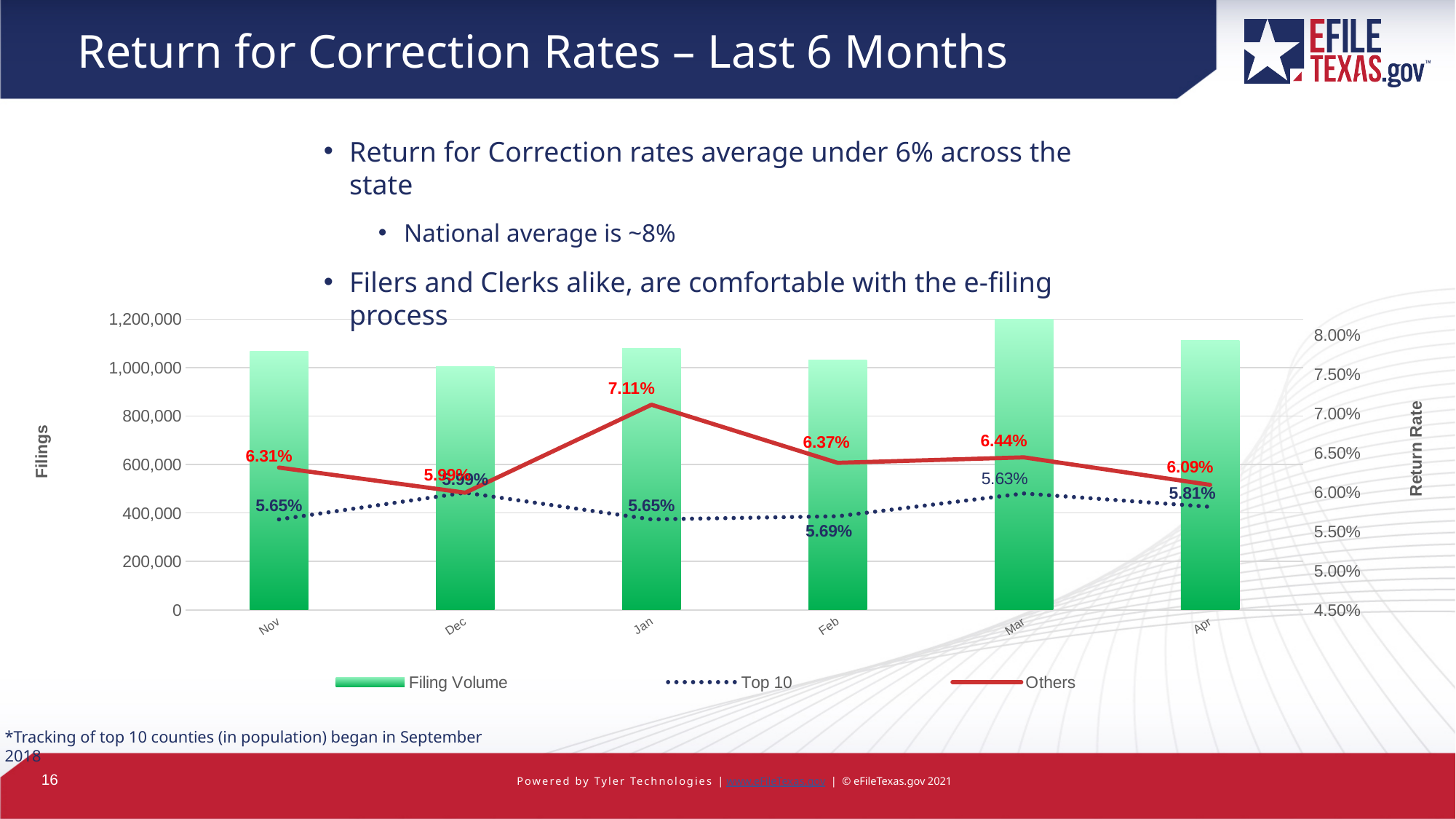
What is the Top 10 return rate for Apr? 5.81% Which month has the highest Filing Volume bar? Mar What is the Others return rate for Jan? 7.11% What kind of chart is this? Combination bar and line chart In Nov, which is higher: the Others rate or the Top 10 rate? Others What is the Others return rate for Mar? 6.44% In which month is the Others return rate lowest? Dec Is the Filing Volume for Apr greater or less than 1,000,000? greater What is the difference between the Others return rate in Jan and in Feb? 0.74% How many series does the legend list? 3 In which month is the Others return rate highest? Jan How many months are shown on the x axis? 6